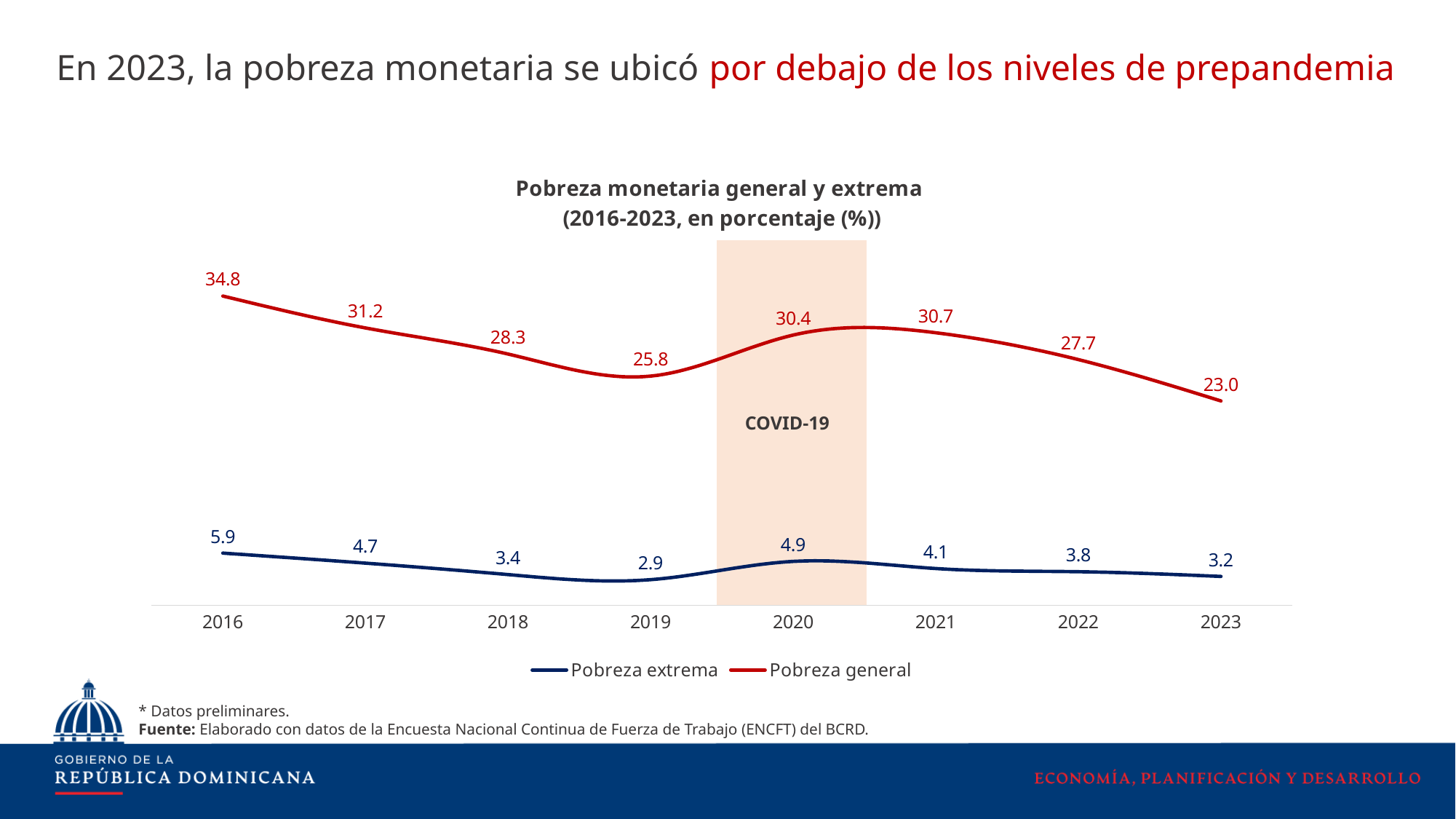
What is the value of Pobreza extrema in 2020? 4.9 How many series does the legend list? 2 What is the difference between Pobreza general in 2019 and in 2020? 4.6 What is the value of Pobreza general in 2023? 23.0 What label appears in the shaded band covering 2020? COVID-19 Does Pobreza general rise or fall from 2021 to 2023? fall Which is larger, Pobreza extrema in 2021 or in 2022? 2021 In which year is Pobreza general highest? 2016 What kind of chart is shown? line chart How many years are shown on the x axis? 8 In which year is Pobreza extrema lowest? 2019 What is the value of Pobreza general in 2016? 34.8